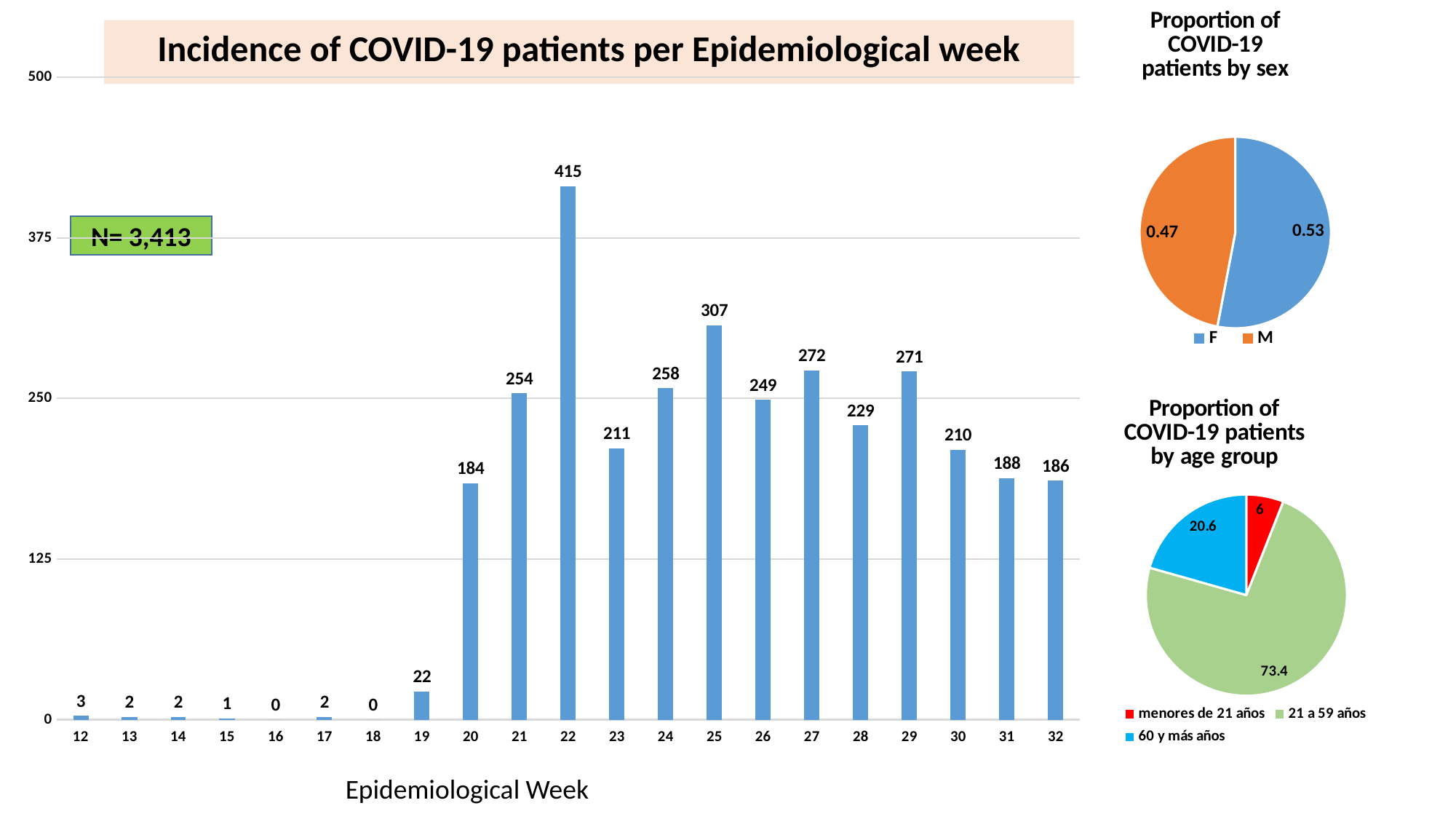
How many entries does the legend of the 'Proportion of COVID-19 patients by age group' pie chart list? 3 In the 'Proportion of COVID-19 patients by age group' pie chart, which age group has the largest slice? 21 a 59 años What kind of chart is the 'Incidence of COVID-19 patients per Epidemiological week' chart? Bar chart In the 'Incidence of COVID-19 patients per Epidemiological week' chart, which week has the highest value? 22 In the 'Incidence of COVID-19 patients per Epidemiological week' chart, do the values rise or fall from week 29 to week 32? Fall In the 'Incidence of COVID-19 patients per Epidemiological week' chart, which is larger, the value for week 27 or week 29? Week 27 In the 'Incidence of COVID-19 patients per Epidemiological week' chart, how many weeks are shown on the x axis? 21 In the 'Incidence of COVID-19 patients per Epidemiological week' chart, what is the value for week 25? 307 In the 'Proportion of COVID-19 patients by sex' pie chart, what is the share for F? 0.53 In the 'Incidence of COVID-19 patients per Epidemiological week' chart, what is the value for week 22? 415 In the 'Proportion of COVID-19 patients by age group' pie chart, what is the value for '60 y más años'? 20.6 In the 'Incidence of COVID-19 patients per Epidemiological week' chart, what is the difference between the values for week 22 and week 25? 108